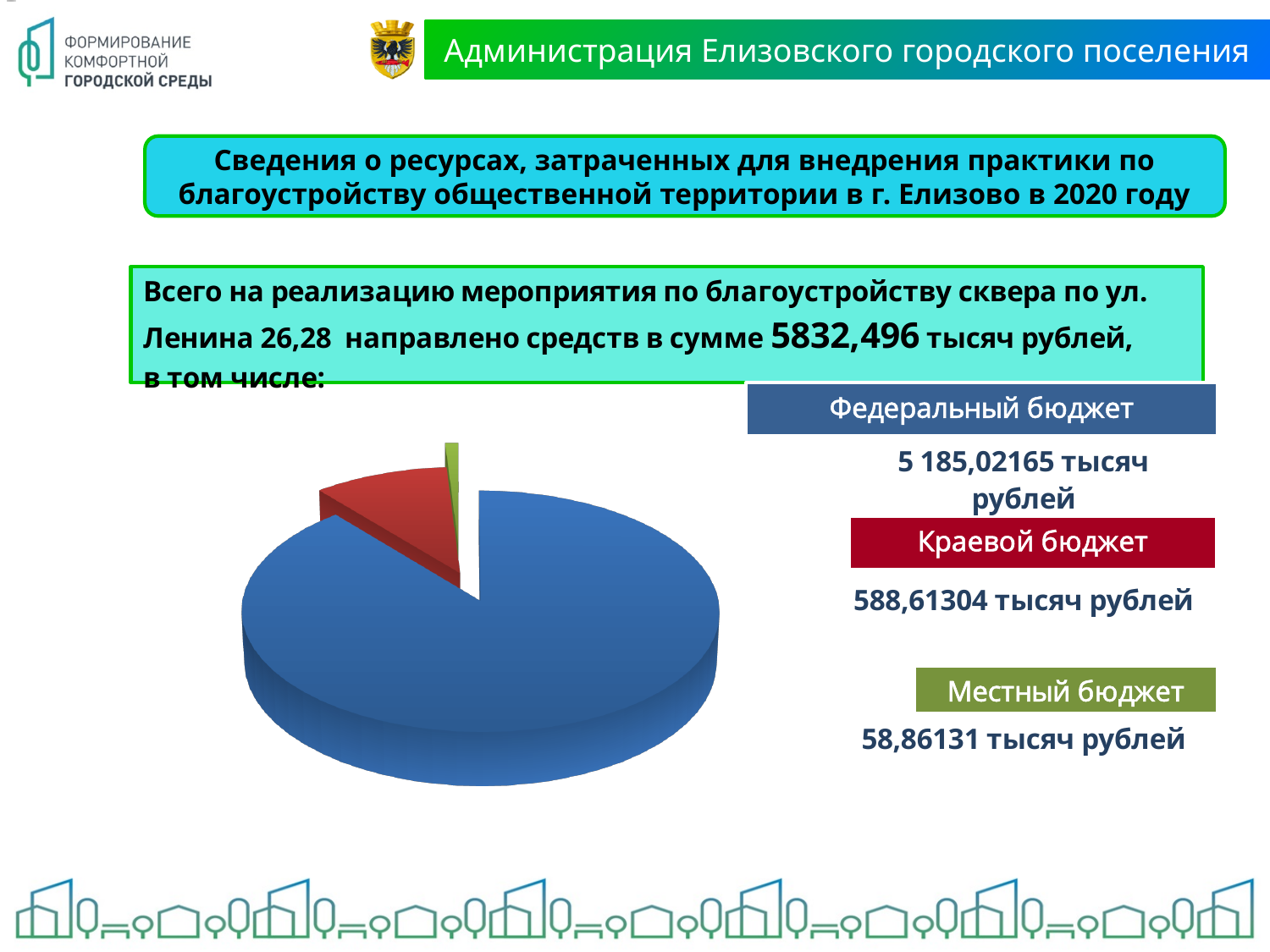
What is the value for Краевой бюджет? 588,61304 тысяч рублей What colour is the slice representing Местный бюджет? green What is the difference between Федеральный бюджет and Краевой бюджет, in тысяч рублей? 4 596,40861 What kind of chart is shown on the slide? pie chart How many budget categories are listed in the legend next to the pie chart? 3 Which budget source accounts for the largest slice of the pie? Федеральный бюджет How many slices does the pie chart have? 3 Which is larger, Краевой бюджет or Местный бюджет? Краевой бюджет What is the value for Федеральный бюджет? 5 185,02165 тысяч рублей What is the total amount of funds across all three budget sources, as stated on the slide? 5832,496 тысяч рублей Which budget source accounts for the smallest slice of the pie? Местный бюджет What is the value for Местный бюджет? 58,86131 тысяч рублей